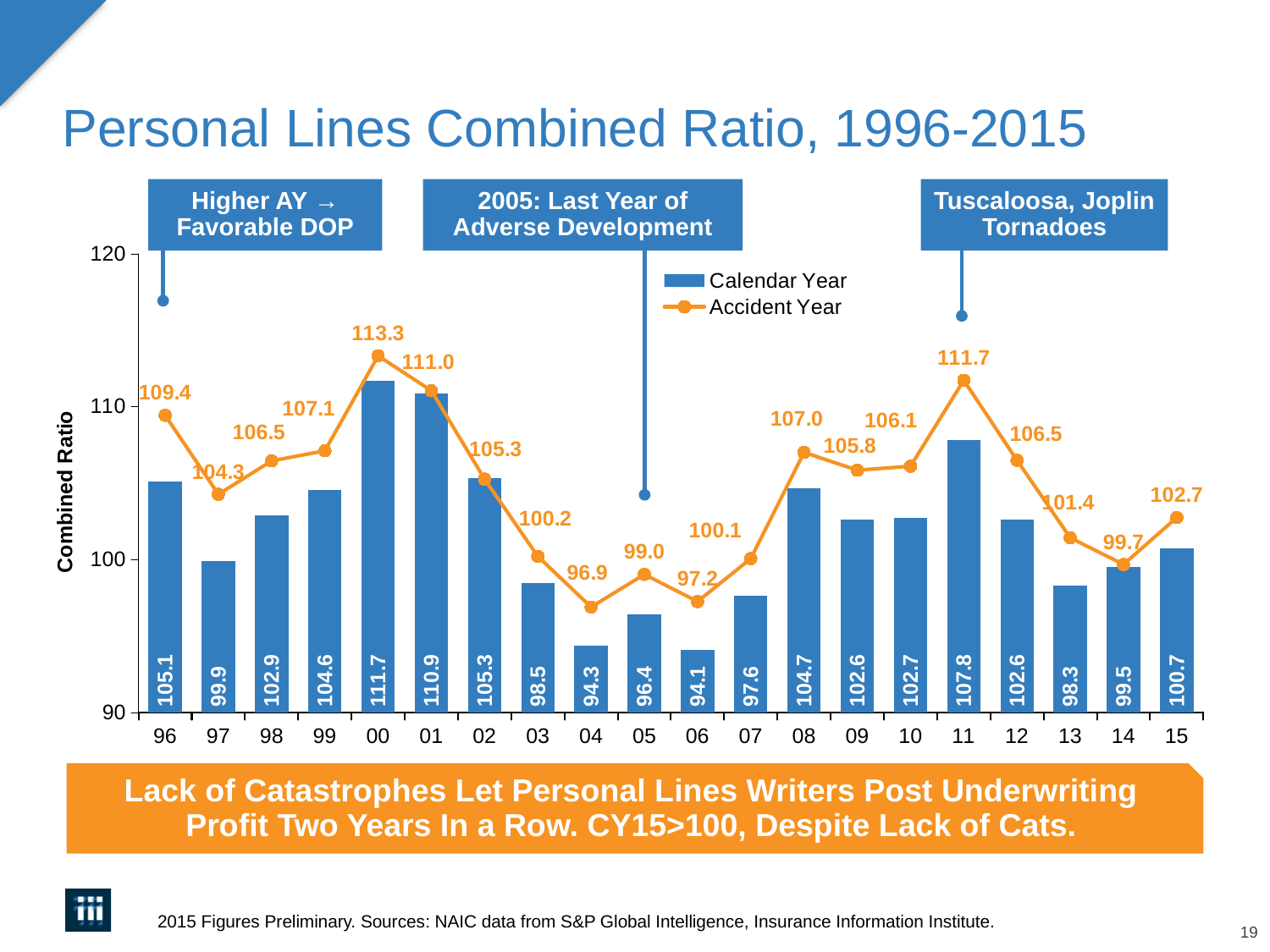
How many series does the legend list? 2 What is the Accident Year combined ratio for 2000? 113.3 Which year has the lowest Accident Year combined ratio? 04 Which year has the lowest Calendar Year combined ratio? 06 What is the Calendar Year combined ratio for 2011? 107.8 Does the Calendar Year combined ratio rise or fall from 2013 to 2015? Rise What is the Calendar Year combined ratio for 2015? 100.7 How many years are shown on the x axis? 20 What kind of chart is used for the Calendar Year series? Bar chart Which year has the highest Calendar Year combined ratio? 00 What is the difference between the Accident Year and Calendar Year combined ratios for 1996? 4.3 Which is larger, the Calendar Year combined ratio for 2008 or for 2012? 2008